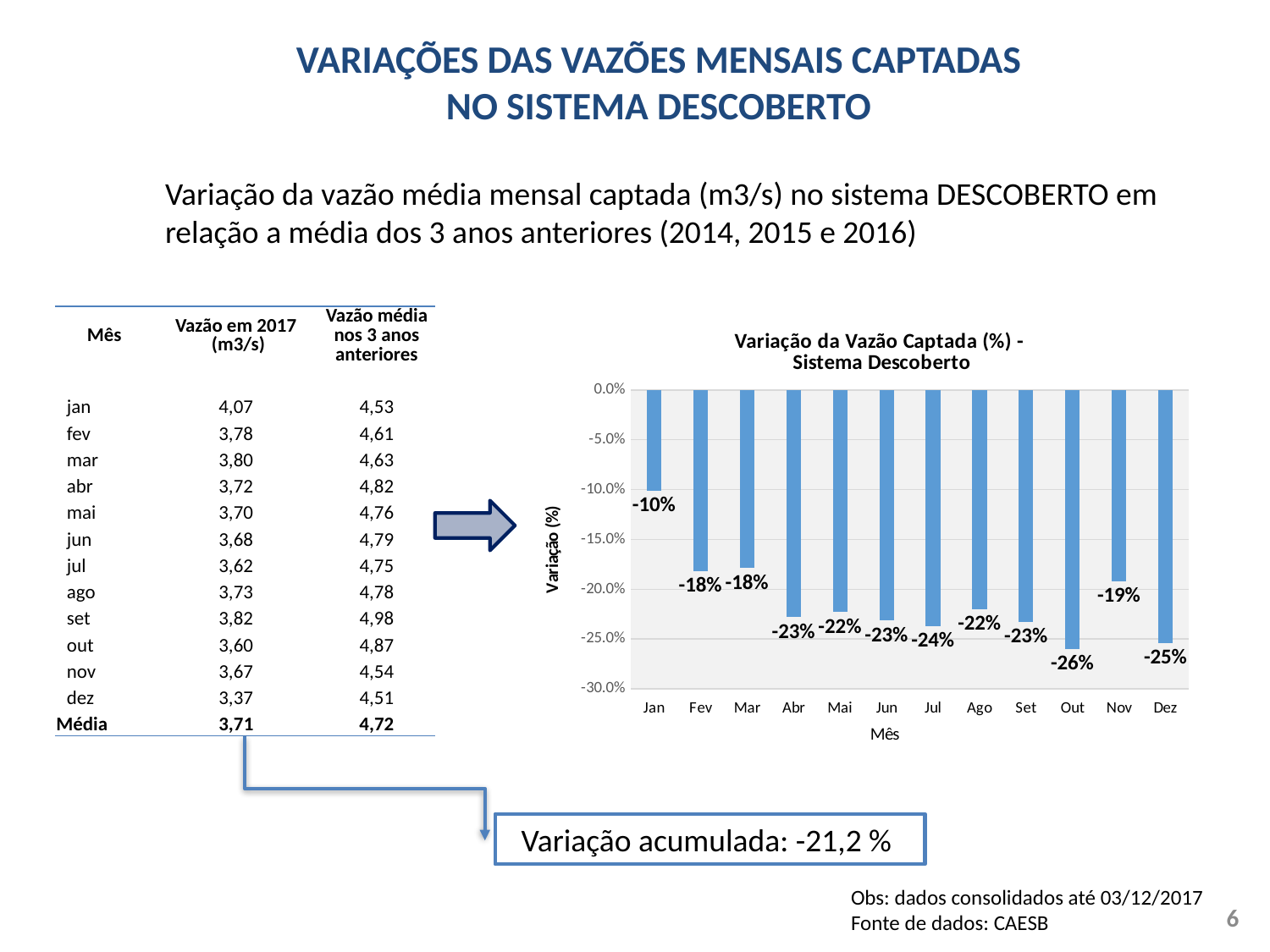
What is the value for Jan in the chart? -10% How many months are plotted in the chart? 12 What is the value for Out in the chart? -26% Which is larger, the value for Jan or the value for Dez? Jan What is the value for Nov in the chart? -19% Which month has the lowest (most negative) value in the chart? Out Do the values rise or fall from Jan to Abr in the chart? Fall What is the difference between the values for Jan and Out in the chart? 16 percentage points What is the value for Jul in the chart? -24% What is the title of the chart? Variação da Vazão Captada (%) - Sistema Descoberto What kind of chart is shown on the slide? Bar chart Which month has the highest (least negative) value in the chart? Jan